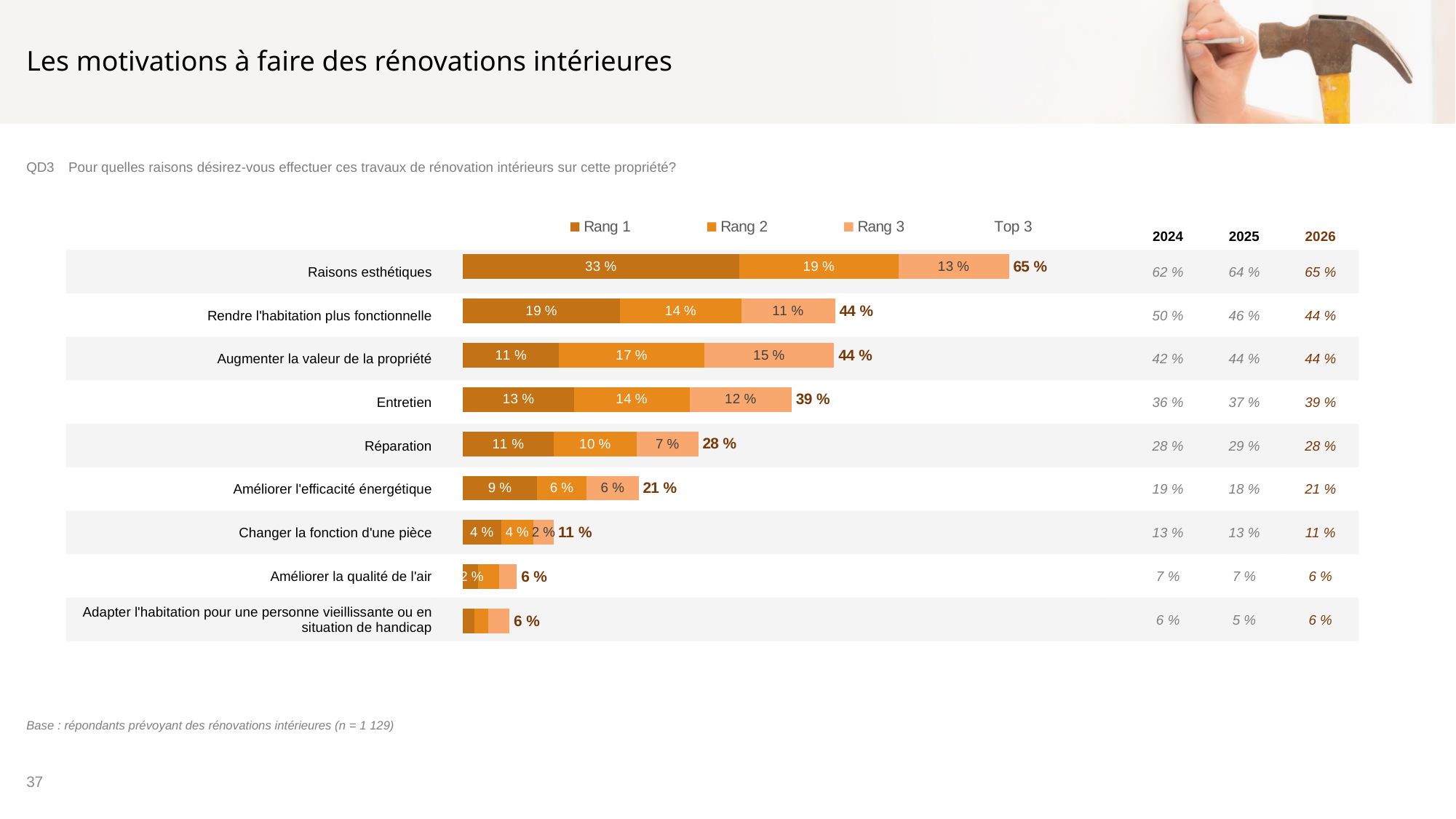
Which category has the highest Top 3 value? Raisons esthétiques What is the Rang 3 value for Entretien? 12 % What is the difference between the Top 3 values for Raisons esthétiques and Entretien? 26 % Which category has the lowest Rang 1 value? Adapter l'habitation pour une personne vieillissante ou en situation de handicap What is the Top 3 value for Réparation? 28 % How many categories are shown in the chart? 9 How many entries does the legend list? 4 What is the Rang 2 value for Augmenter la valeur de la propriété? 17 % What is the total of the stacked bar for Améliorer l'efficacité énergétique? 21 % What kind of chart is shown on the slide? Stacked bar chart What is the Rang 1 value for Raisons esthétiques? 33 % Which is larger, the Rang 1 value for Rendre l'habitation plus fonctionnelle or the Rang 1 value for Entretien? Rendre l'habitation plus fonctionnelle